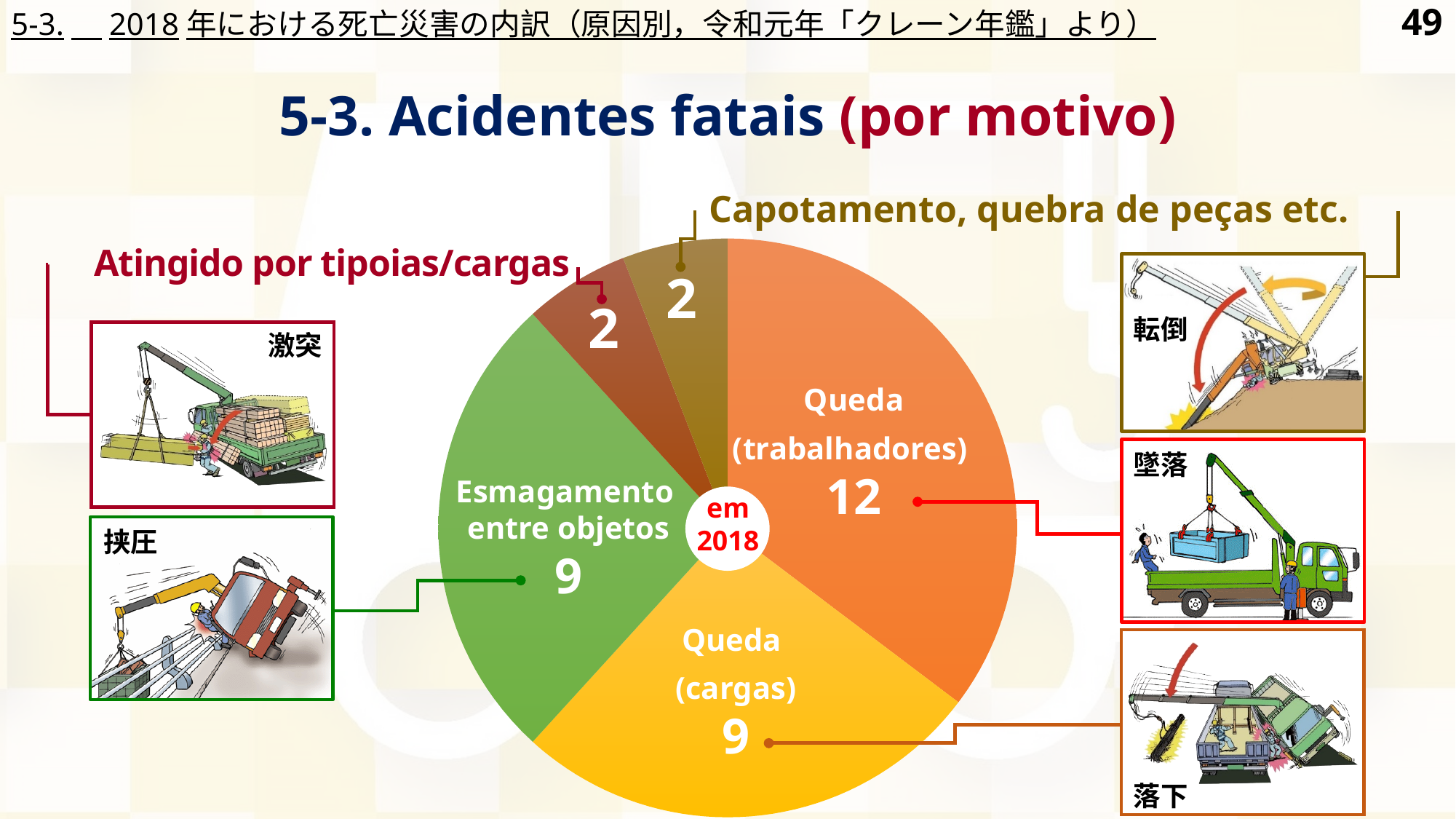
What is the value for Queda (trabalhadores)? 12 What text is shown in the centre of the pie chart? em 2018 What is the value for Atingido por tipoias/cargas? 2 Which category has the highest value in the pie chart? Queda (trabalhadores) How many slices does the pie chart have? 5 What is the difference between Esmagamento entre objetos and Atingido por tipoias/cargas? 7 Which is larger, Queda (trabalhadores) or Queda (cargas)? Queda (trabalhadores) What kind of chart is shown on the slide? Pie chart What is the difference between Queda (trabalhadores) and Queda (cargas)? 3 What is the value for Capotamento, quebra de peças etc.? 2 What is the value for Esmagamento entre objetos? 9 Which categories share the lowest value in the pie chart? Atingido por tipoias/cargas and Capotamento, quebra de peças etc.